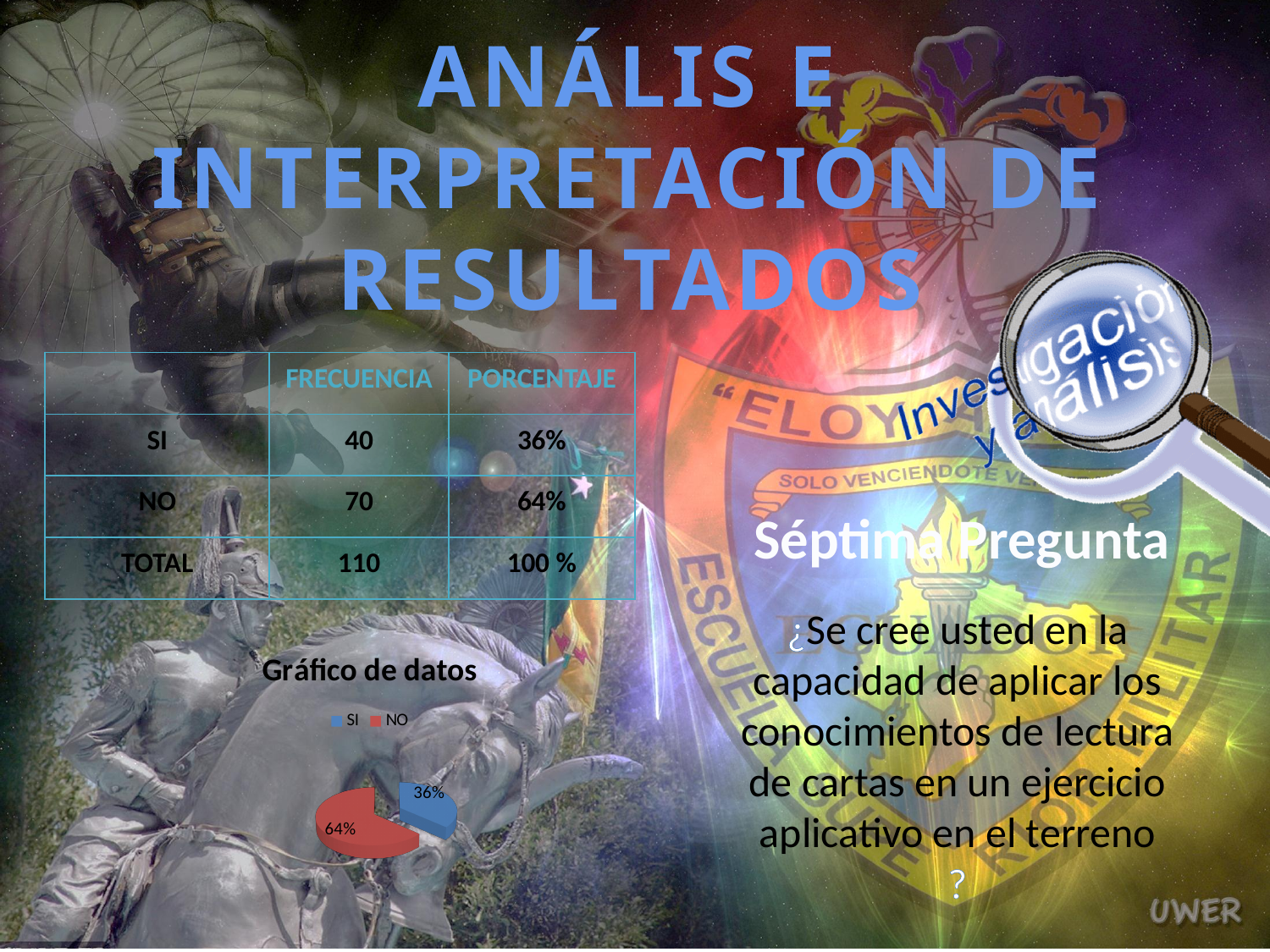
Which slice of the pie is the smallest? SI What share of the pie does the NO slice represent? 64% Which slice of the pie is the largest? NO What is the difference in percentage points between the NO slice and the SI slice? 28 What kind of chart is shown on the slide? pie chart How many entries does the chart legend list? 2 How many slices does the pie chart have? 2 What colour is the NO slice in the pie chart? red What is the data label shown on the blue slice of the pie? 36% What is the title of the chart? Gráfico de datos Which is larger, the SI slice or the NO slice? NO What share of the pie does the SI slice represent? 36%